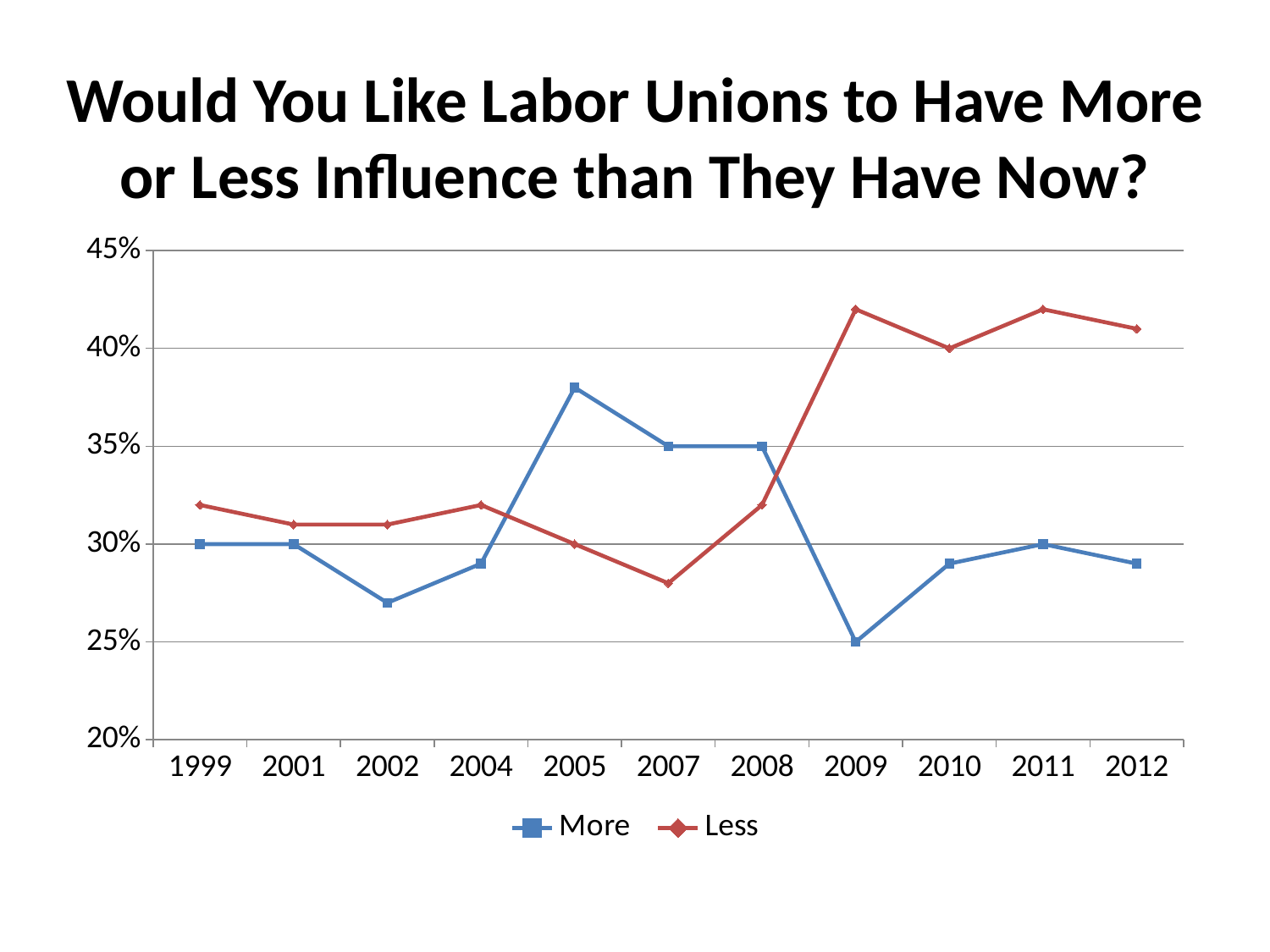
Is the value for More in 2002 greater or less than 30%? less Which series is shown in red? Less What is the value for Less in 2010? 40% In which year is the More series at its highest? 2005 How many series does the legend list? 2 What is the value for More in 2007? 35% What is the value for More in 1999? 30% How many years are shown on the x axis? 11 Is the value for Less in 2009 greater or less than 40%? greater What is the value for More in 2009? 25% In 2005, which series has the larger value, More or Less? More What kind of chart is shown on the slide? line chart